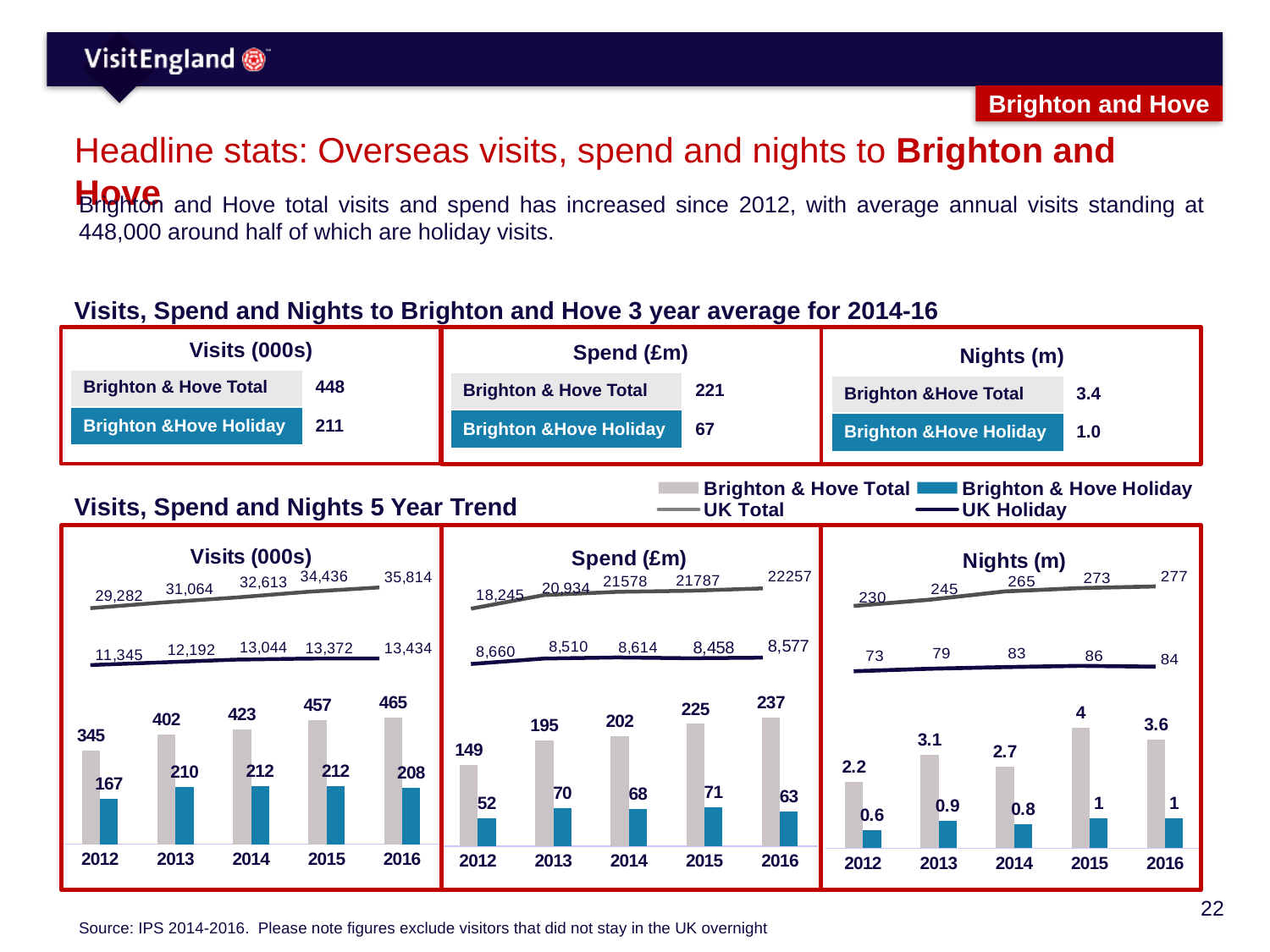
In the 5 Year Trend charts, what colour are the Brighton & Hove Holiday bars? Blue In the Spend (£m) chart, does the Brighton & Hove Total value rise or fall from 2012 to 2016? rise In the Spend (£m) chart, what is the Brighton & Hove Total value for 2014? 202 How many series does the legend above the 5 Year Trend charts list? 4 In the Visits (000s) chart, what is the difference between the Brighton & Hove Total values for 2016 and 2012? 120 In the Nights (m) chart, what is the UK Total value for 2015? 273 In the Visits (000s) chart, what is the Brighton & Hove Total value for 2016? 465 In the Spend (£m) chart, which year has the highest Brighton & Hove Total value? 2016 How many years are shown on the x axis of the Nights (m) chart? 5 In the Spend (£m) chart, is the Brighton & Hove Holiday value for 2013 larger or smaller than the value for 2016? larger In the Nights (m) chart, which year has the lowest Brighton & Hove Holiday value? 2012 In the Visits (000s) chart, what is the Brighton & Hove Holiday value for 2012? 167